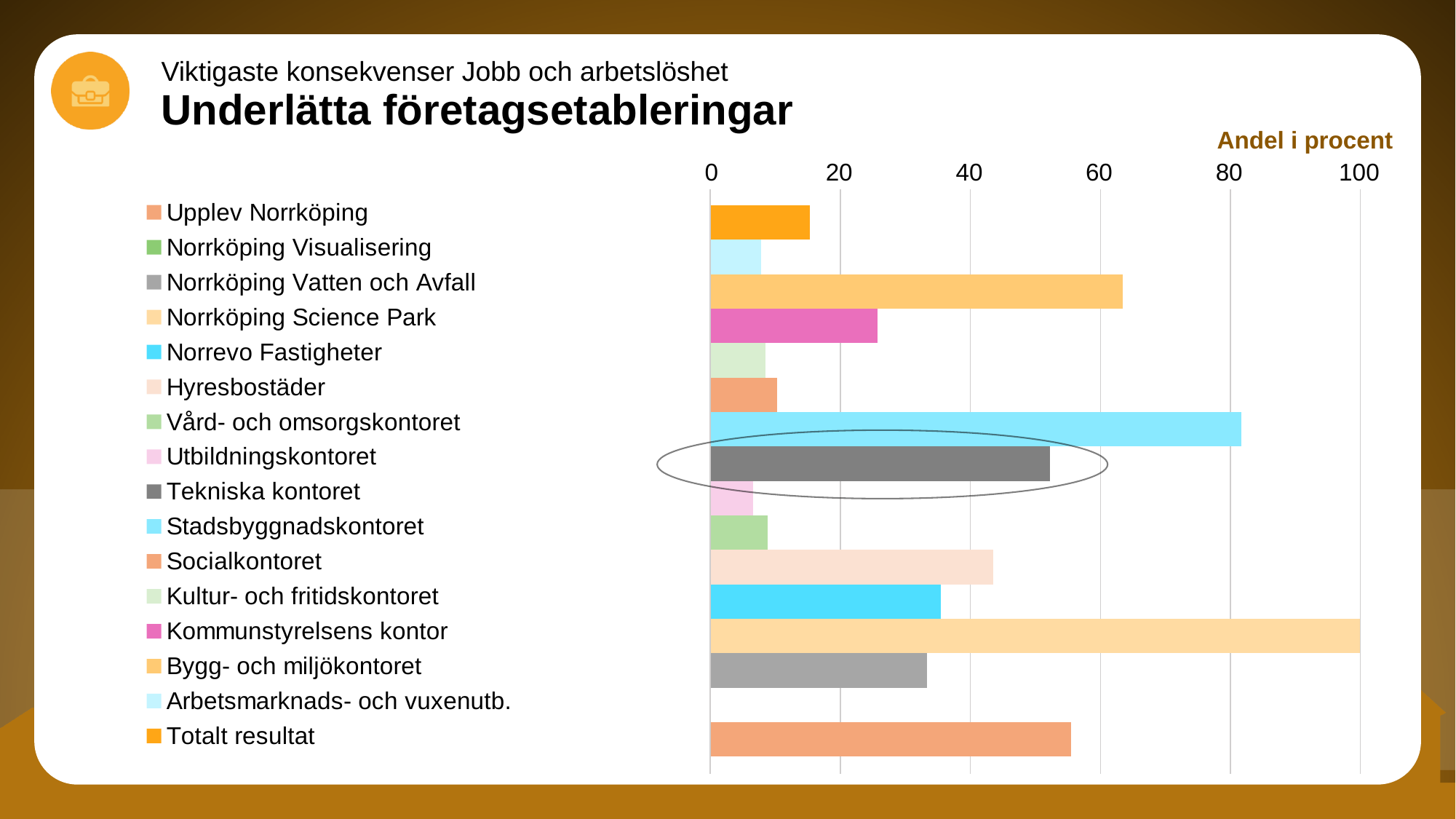
Is the value for Bygg- och miljökontoret greater or less than 60? greater Which is larger, the value for Stadsbyggnadskontoret or the value for Tekniska kontoret? Stadsbyggnadskontoret What is the value for Norrköping Science Park? 100 Is the value for Totalt resultat greater or less than 20? less Is the value for Tekniska kontoret greater or less than 60? less Which category has the highest value? Norrköping Science Park What kind of chart is shown on the slide? bar chart Which is larger, the value for Hyresbostäder or the value for Bygg- och miljökontoret? Bygg- och miljökontoret How many entries does the legend list? 16 What is the label shown above the horizontal axis of the chart? Andel i procent